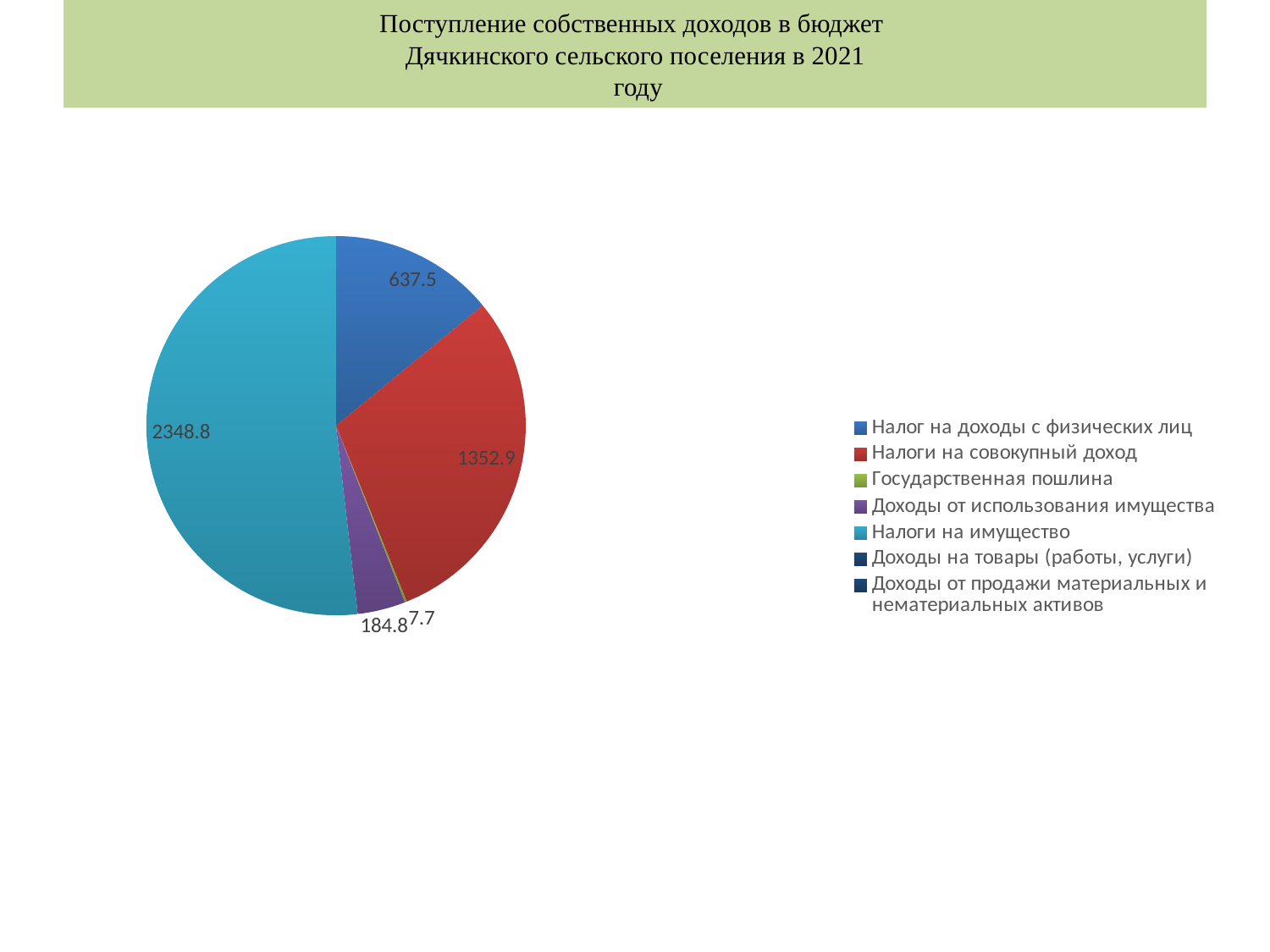
Which category has the largest slice of the pie? Налоги на имущество What is the value for Государственная пошлина? 7.7 Which is larger, the value for Налог на доходы с физических лиц or the value for Доходы от использования имущества? Налог на доходы с физических лиц What is the value for Налог на доходы с физических лиц? 637.5 What is the value for Налоги на совокупный доход? 1352.9 What is the difference between the values for Налоги на имущество and Налоги на совокупный доход? 995.9 What type of chart is shown on the slide? pie chart How many entries does the legend list? 7 What is the value for Налоги на имущество? 2348.8 Which labelled category has the smallest slice of the pie? Государственная пошлина What is the title of the chart? Поступление собственных доходов в бюджет Дячкинского сельского поселения в 2021 году What is the value for Доходы от использования имущества? 184.8